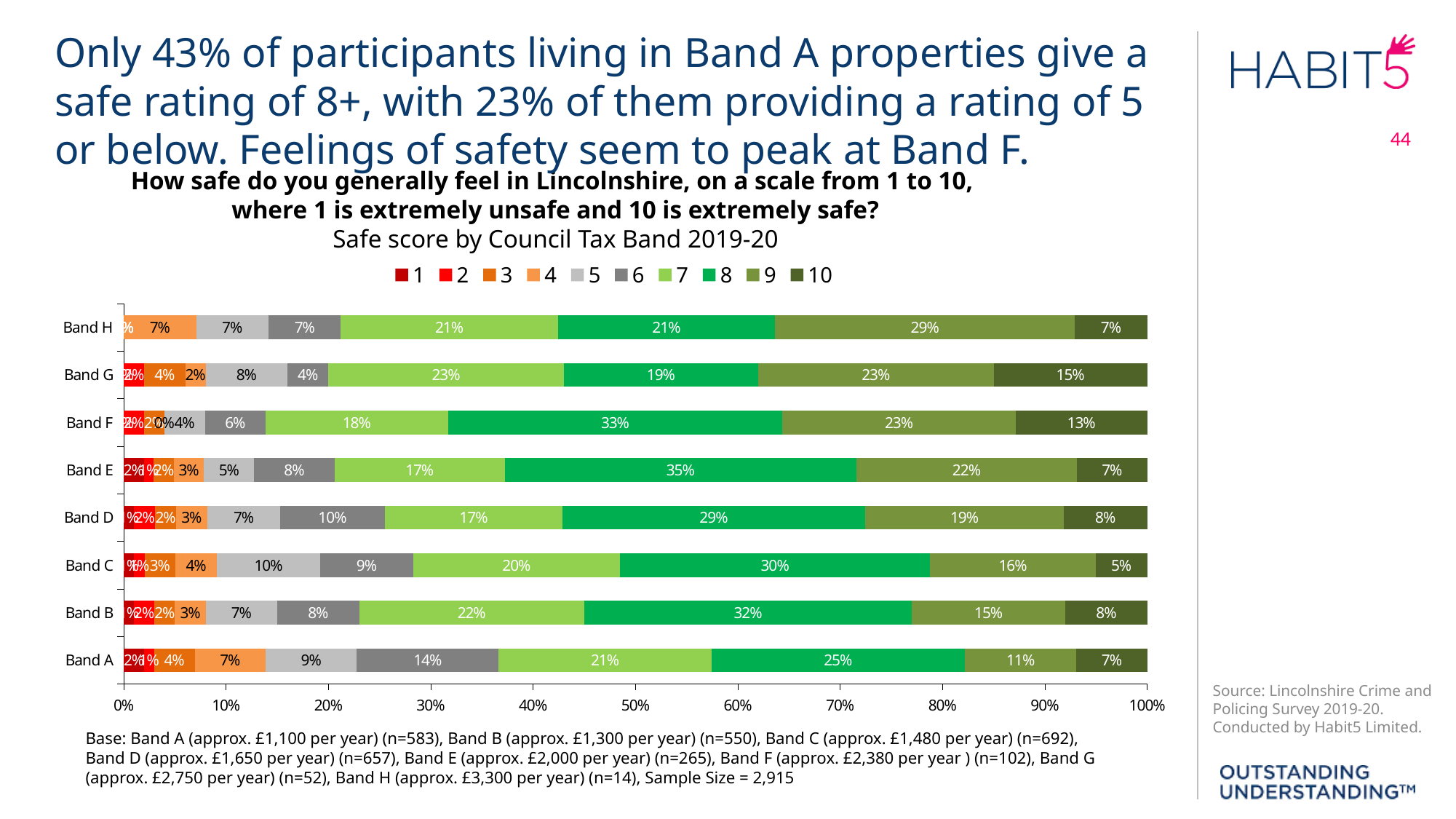
How many council tax bands are shown on the chart? 8 Which is larger: the share giving a score of 7 in Band B or in Band D? Band B What is the subtitle of the chart describing the breakdown shown? Safe score by Council Tax Band 2019-20 What kind of chart is shown on the slide? Stacked bar chart Which council tax band has the lowest share of participants giving a safe score of 9? Band A What percentage of Band G participants gave a safe score of 10? 15% Which council tax band has the highest share of participants giving a safe score of 8? Band E What is the difference in percentage points between the share giving a score of 8 in Band F and in Band A? 8 percentage points How many series does the legend list? 10 What percentage of Band A participants gave a safe score of 6? 14% What percentage of Band H participants gave a safe score of 9? 29% What percentage of Band E participants gave a safe score of 8? 35%